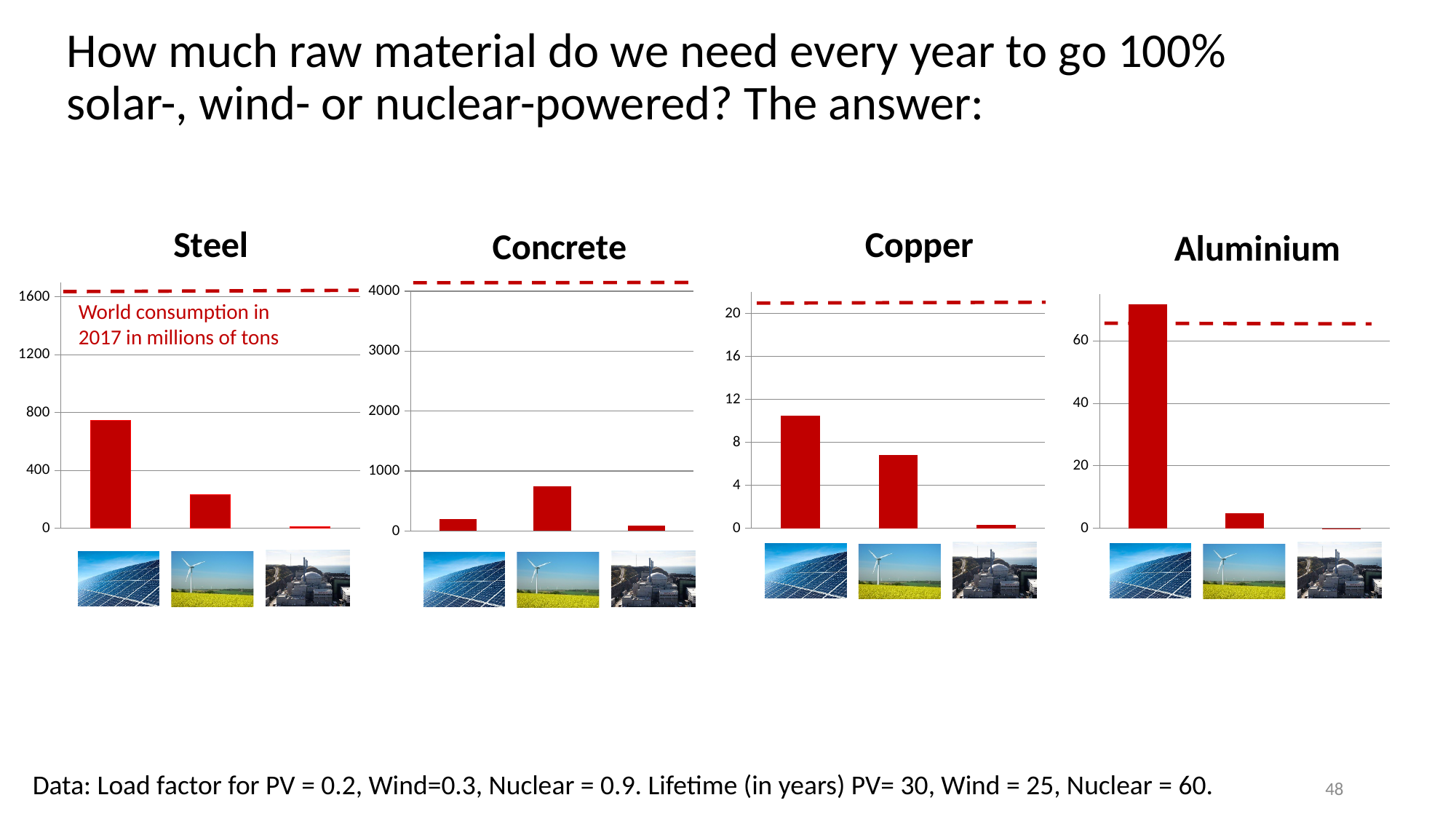
In the Steel chart, is the value of the first (solar) bar greater or less than 400? greater In the Steel chart, which bar is the highest: the first (solar), second (wind) or third (nuclear)? the first (solar) In the Aluminium chart, which is larger, the first (solar) bar or the second (wind) bar? the first (solar) bar In the Concrete chart, which bar is the highest: the first (solar), second (wind) or third (nuclear)? the second (wind) How many bars does the Copper chart contain? 3 In the Concrete chart, is the value of the second (wind) bar greater or less than 1000? less In the Steel chart, is the value of the second (wind) bar greater or less than 400? less According to the Steel chart, what does the red dashed line represent? World consumption in 2017 in millions of tons What kind of chart is the Steel chart? bar chart In the Copper chart, which bar is the lowest: the first (solar), second (wind) or third (nuclear)? the third (nuclear)